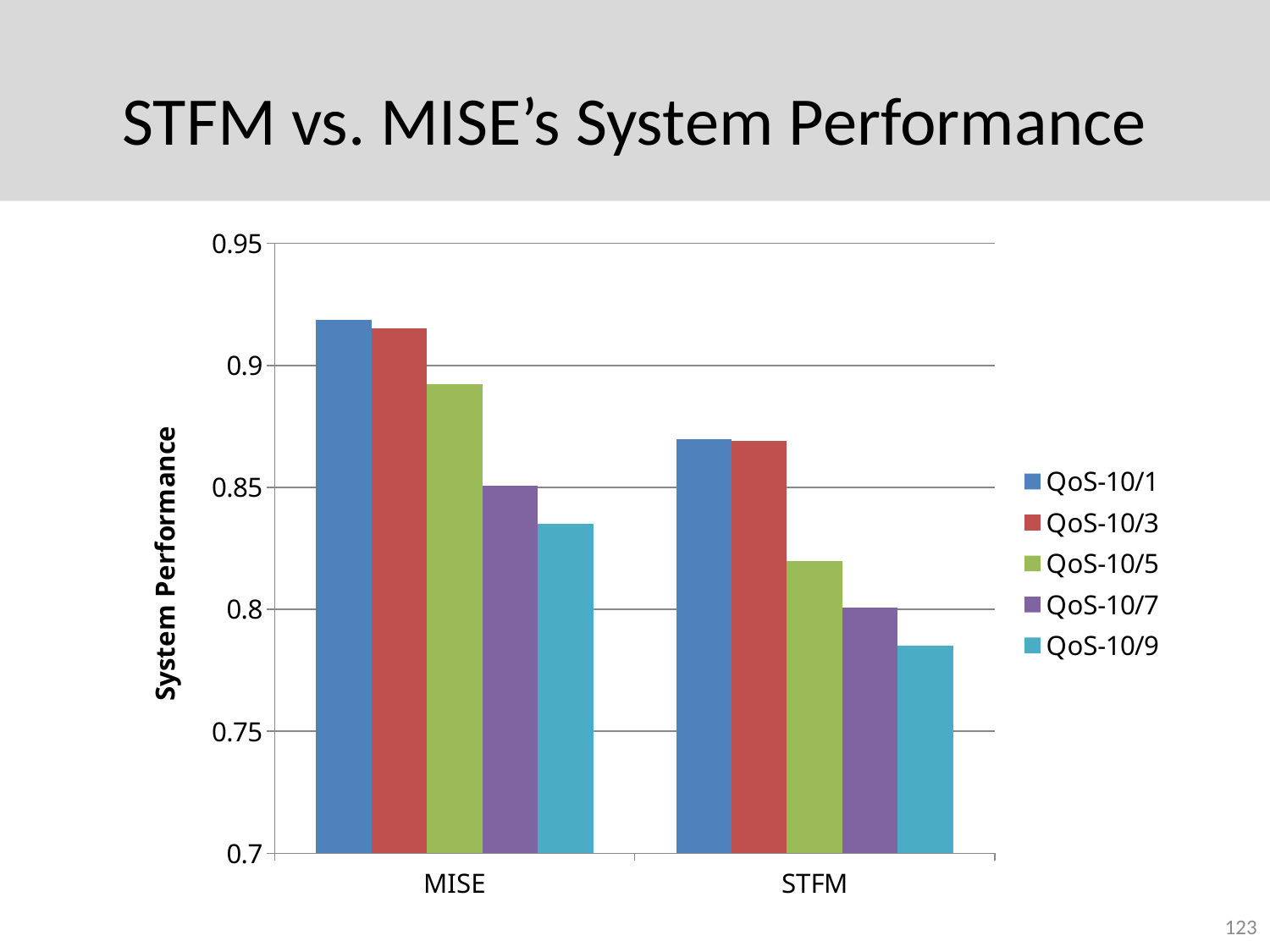
Which is larger, the QoS-10/5 value for MISE or the QoS-10/5 value for STFM? MISE Is the value for QoS-10/5 under MISE greater or less than 0.9? less How many categories are shown on the x axis? 2 How many series does the legend list? 5 What kind of chart is shown on the slide? bar chart Is the value for QoS-10/1 under MISE greater or less than 0.9? greater Is the value for QoS-10/1 under STFM greater or less than 0.85? greater What is the title of the y axis? System Performance Within the MISE category, do the values rise or fall going from QoS-10/1 to QoS-10/9? fall Which series has the lowest value within the STFM category? QoS-10/9